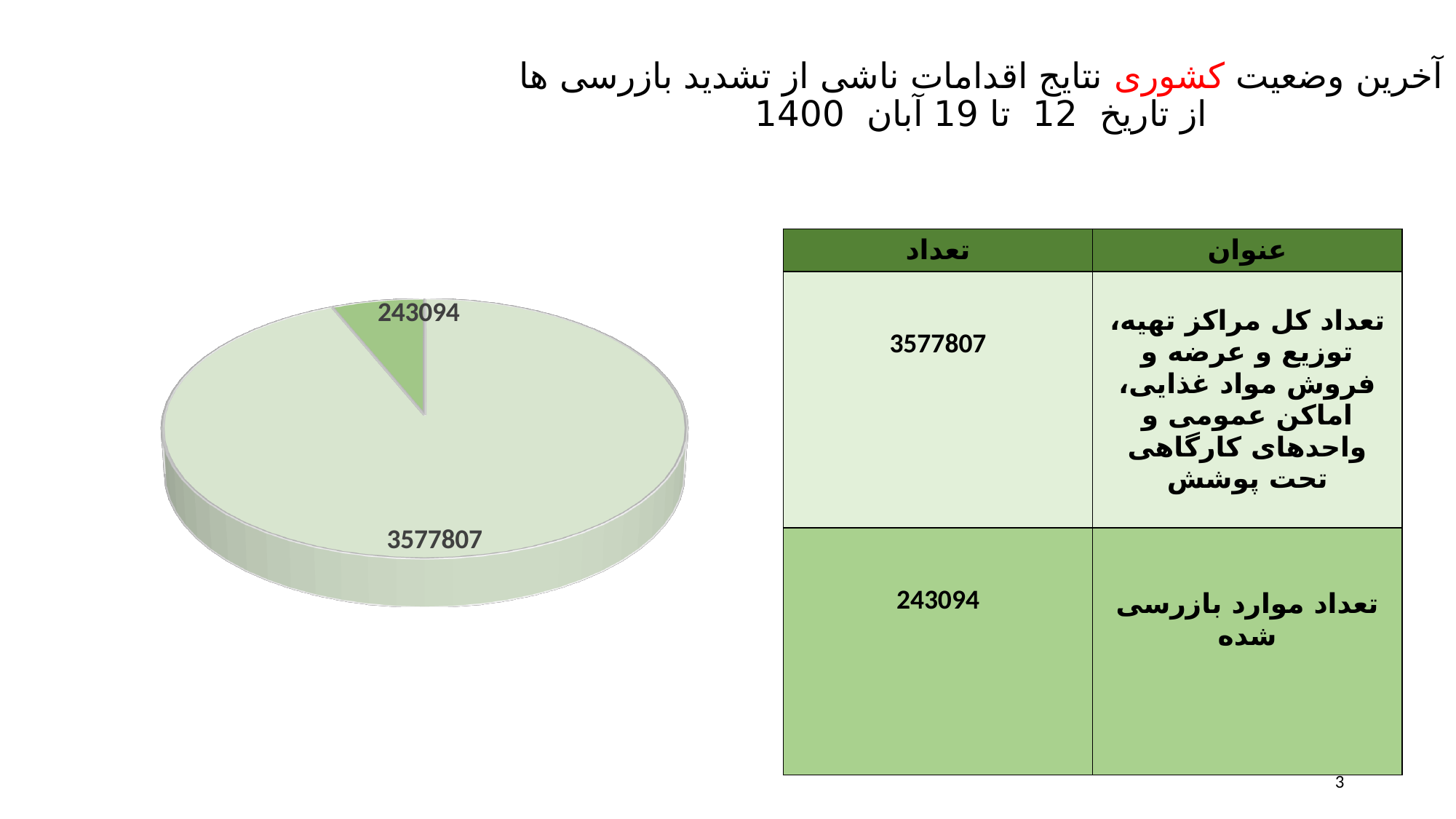
What value does the pie chart show for the number of inspected cases (تعداد موارد بازرسی شده)? 243094 How many slices does the pie chart have? 2 What date range does the slide title give for the data? 12 تا 19 آبان 1400 What is the total of the two values shown on the pie chart? 3820901 Which slice of the pie chart is drawn in the darker green colour? 243094 What is the difference between the two values shown on the pie chart? 3334713 What is the value shown on the largest slice of the pie chart? 3577807 What value does the pie chart show for the total number of covered centres and units (تعداد کل مراکز ... تحت پوشش)? 3577807 What is the value shown on the smallest slice of the pie chart? 243094 What kind of chart is shown on the slide? pie chart Which is larger in the pie chart: the slice labelled 3577807 or the slice labelled 243094? 3577807